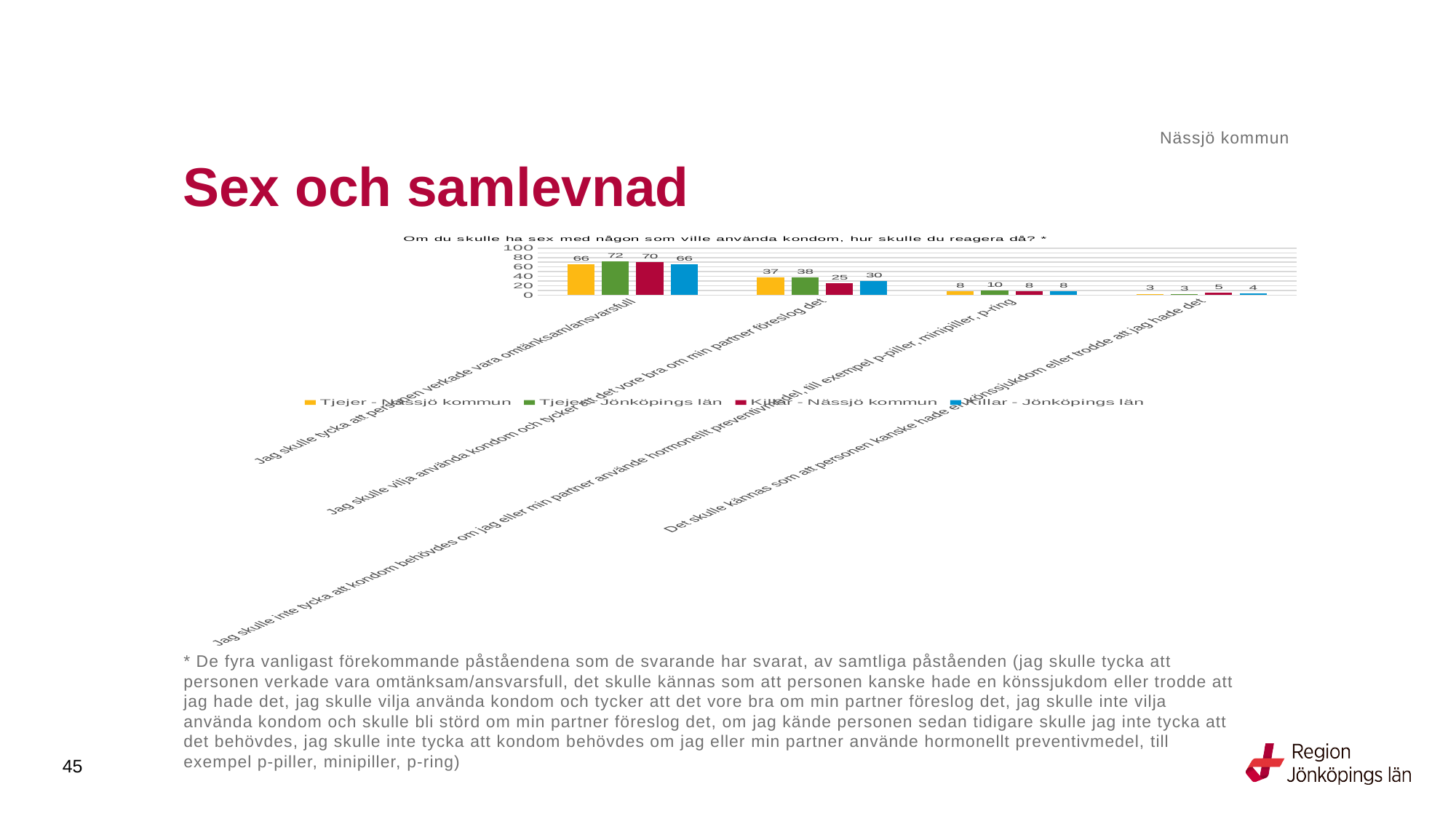
Which series has the highest value for "Jag skulle tycka att personen verkade vara omtänksam/ansvarsfull"? Tjejer - Jönköpings län What is the value for Killar - Nässjö kommun for "Jag skulle vilja använda kondom och tycker att det vore bra om min partner föreslog det"? 25 How many series does the legend list? 4 What is the difference between Tjejer - Jönköpings län and Killar - Nässjö kommun for "Jag skulle vilja använda kondom och tycker att det vore bra om min partner föreslog det"? 13 How many categories are shown on the x axis? 4 What is the value for Tjejer - Jönköpings län for "Jag skulle tycka att personen verkade vara omtänksam/ansvarsfull"? 72 What kind of chart is shown on the slide? Bar chart Do the values for Tjejer - Nässjö kommun rise or fall across the categories from left to right? Fall What is the value for Tjejer - Nässjö kommun for "Det skulle kännas som att personen kanske hade en könssjukdom eller trodde att jag hade det"? 3 What colour represents Killar - Jönköpings län in the chart? Blue Which series has the lowest value for "Jag skulle vilja använda kondom och tycker att det vore bra om min partner föreslog det"? Killar - Nässjö kommun For "Jag skulle tycka att personen verkade vara omtänksam/ansvarsfull", which is larger: Killar - Nässjö kommun or Killar - Jönköpings län? Killar - Nässjö kommun